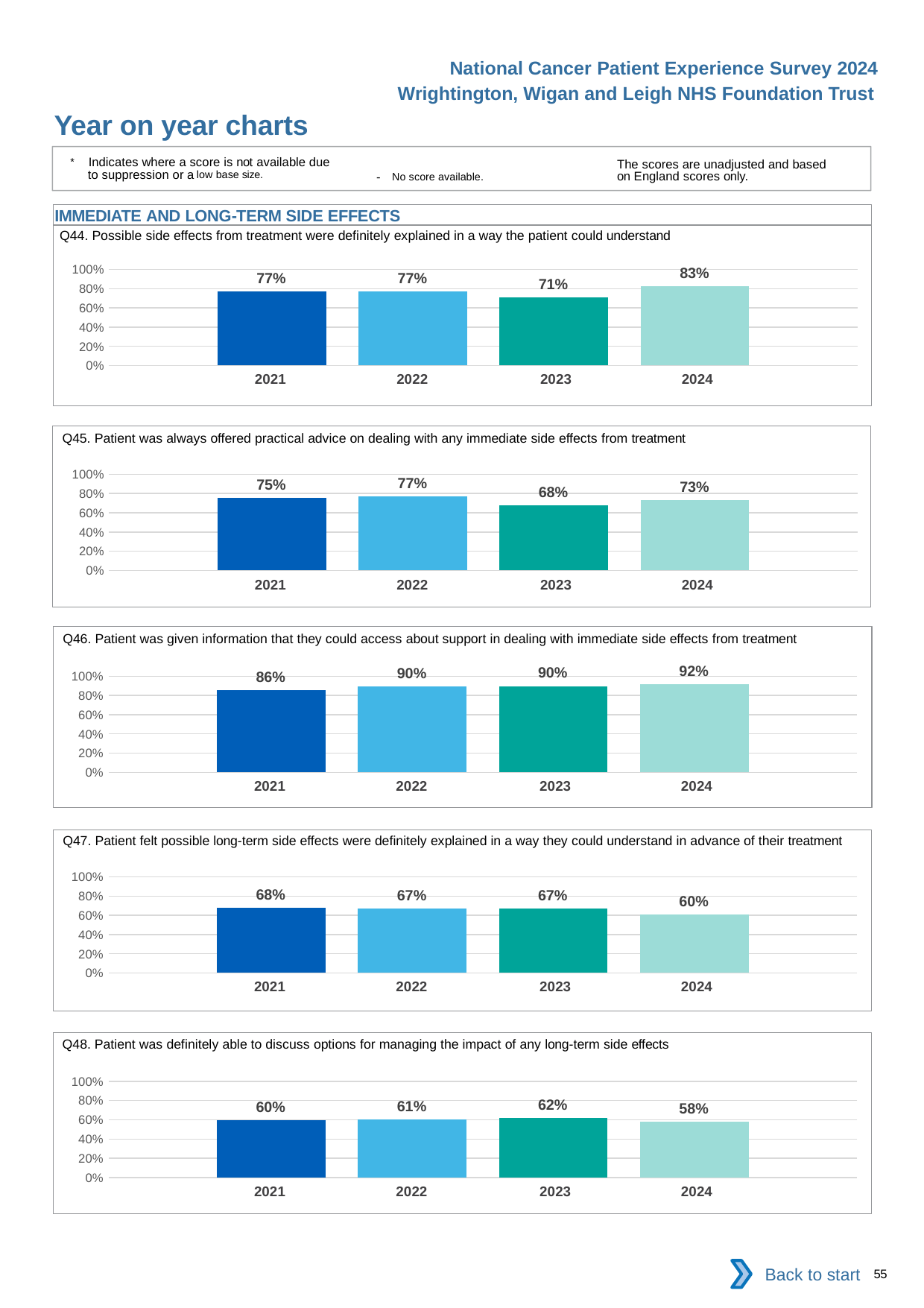
In the Q45 chart, which year has the highest value? 2022 In the Q45 chart, what is the difference between the 2022 and 2023 values? 9 percentage points In the Q48 chart, which year has the lowest value? 2024 In the Q47 chart, is the value for 2024 larger or smaller than the value for 2021? smaller How many years are shown on the x axis of the Q48 chart? 4 In the Q48 chart, what is the value for 2023? 62% In the Q44 chart, what is the value for 2024? 83% In the Q44 chart, which year has the lowest value? 2023 In the Q46 chart, what is the value for 2021? 86% In the Q46 chart, which year has the highest value? 2024 What type of chart is the Q44 chart? bar chart In the Q47 chart, what is the difference between the 2021 and 2024 values? 8 percentage points